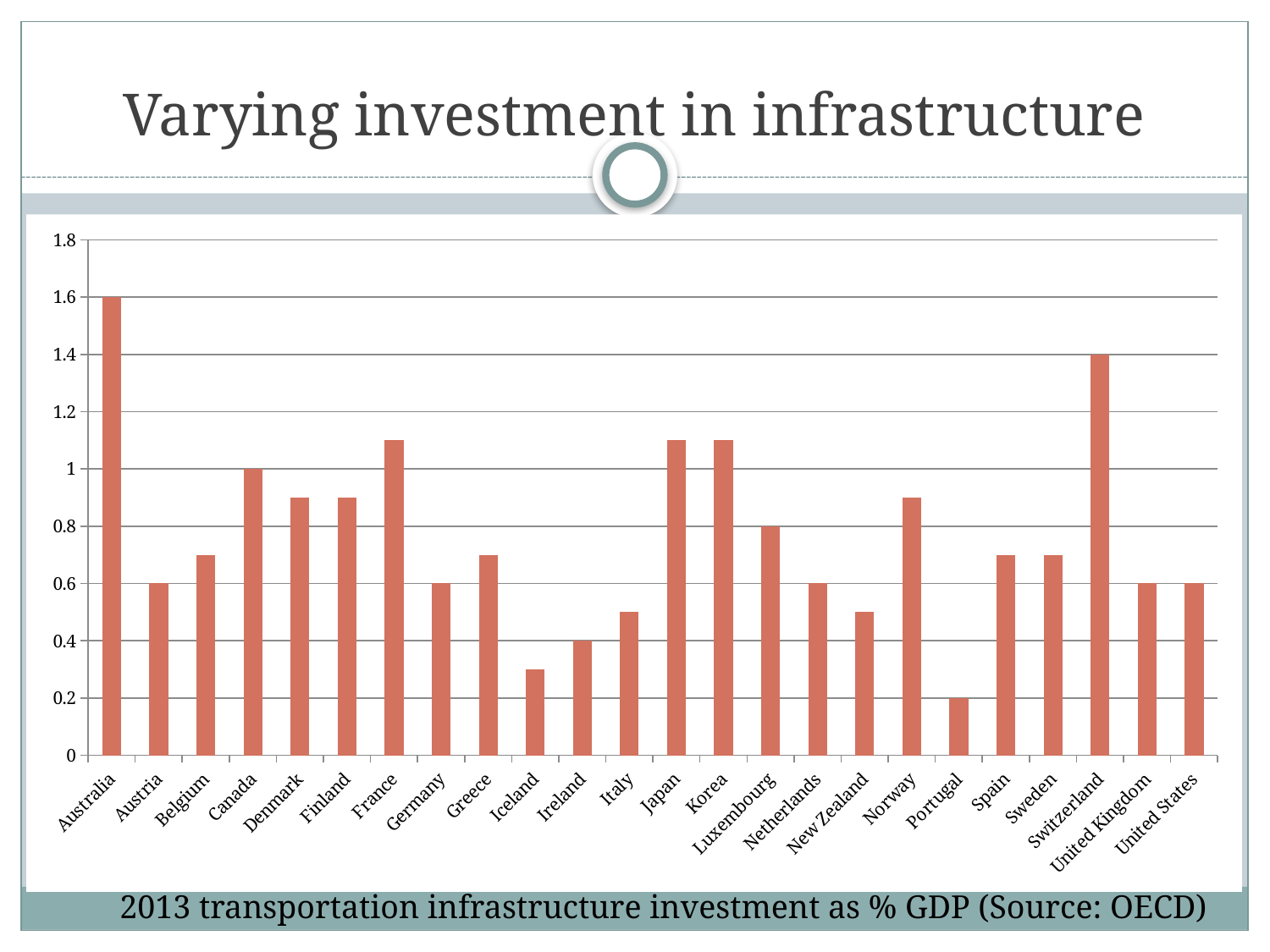
Which country has the highest transportation infrastructure investment as % GDP? Australia What kind of chart is shown on the slide? bar chart What is the value for Canada? 1 What is the value for Portugal? 0.2 What is the value for Luxembourg? 0.8 What is the value for Switzerland? 1.4 What is the difference between the values for Australia and Switzerland? 0.2 What is the value for Australia? 1.6 Which is larger, the value for Iceland or the value for Ireland? Ireland Is the value for France greater or less than 1? greater Which country has the lowest transportation infrastructure investment as % GDP? Portugal How many countries are shown on the chart? 24